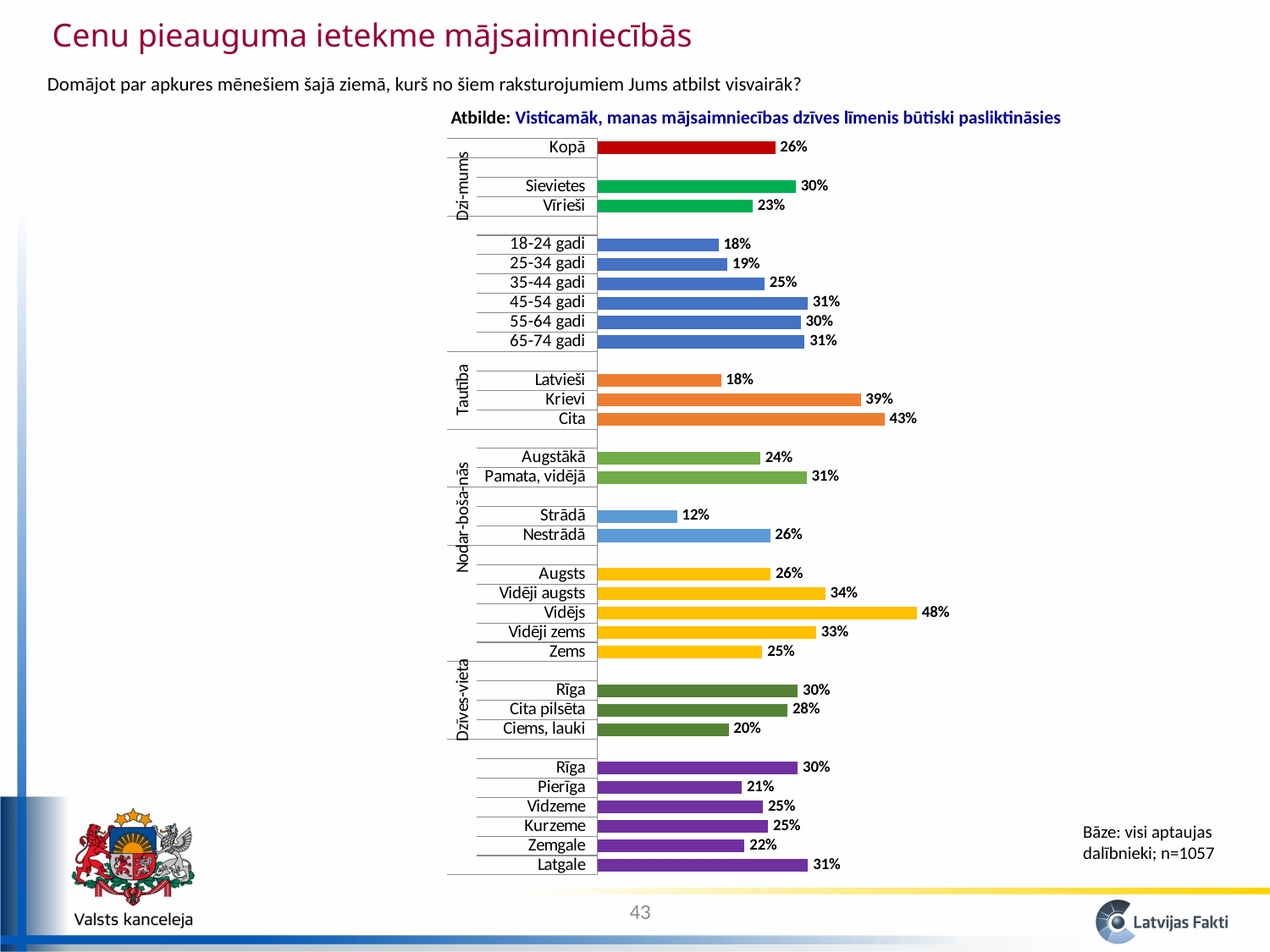
Which category has the lowest value in the chart? Strādā What is the value for Krievi? 39% What is the value for Strādā? 12% Which is larger, the value for Pamata, vidējā or the value for Augstākā? Pamata, vidējā What is the difference between the values for Cita and Latvieši? 25% Which category has the highest value in the chart? Vidējs What is the value for Zemgale? 22% Which is larger, the value for Ciems, lauki or the value for Cita pilsēta? Cita pilsēta What is the difference between the values for Sievietes and Vīrieši? 7% What is the value for Latgale? 31% What kind of chart is shown on the slide? Bar chart What is the value for Kopā? 26%